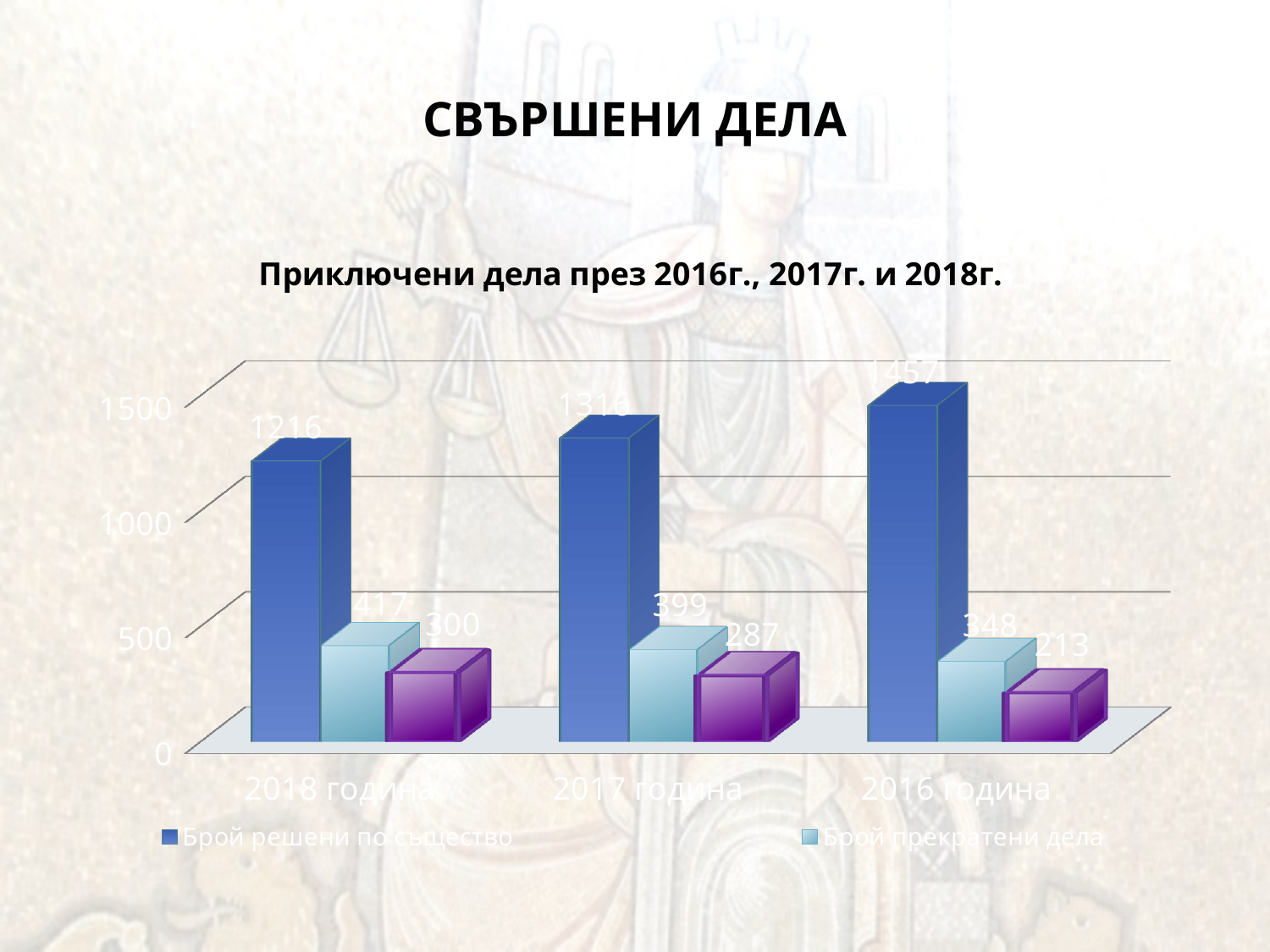
What is the title of the chart? Приключени дела през 2016г., 2017г. и 2018г. How many year categories are shown on the x axis? 3 Which year has the lowest value for Брой прекратени дела? 2016 година Which is larger: Брой прекратени дела for 2018 година or for 2017 година? 2018 година What is the value of Брой прекратени дела for 2016 година? 348 Which year has the highest value for Брой решени по същество? 2016 година What is the value of the purple bar for 2017 година? 287 Do the values of Брой решени по същество rise or fall from left to right along the x axis? rise What kind of chart is shown on the slide? bar chart What is the difference between Брой решени по същество for 2016 година and 2018 година? 241 What is the value of Брой решени по същество for 2018 година? 1216 Is the value of Брой решени по същество for 2017 година greater or less than 1000? greater